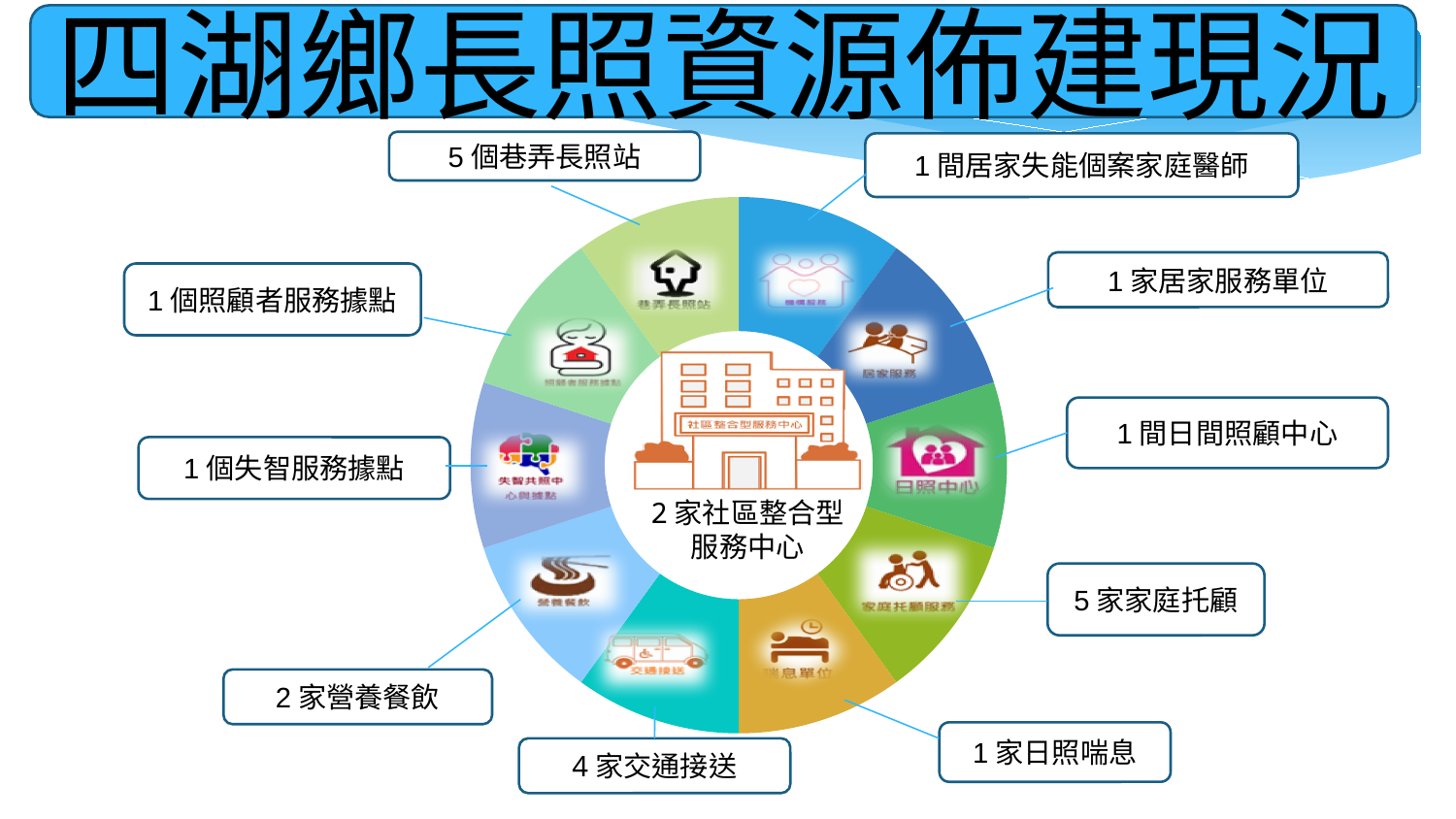
圖中家庭托顧有幾家？ 5 家 圖中日間照顧中心有幾間？ 1 間 圖中失智服務據點有幾個？ 1 個 這張圖的標題是什麼？ 四湖鄉長照資源佈建現況 環狀圖共分成幾個區塊？ 10 交通接送與營養餐飲，哪一項的數量較多？ 交通接送 圖中巷弄長照站有幾個？ 5 個 這是什麼類型的圖？ 環狀圖（甜甜圈圖） 圖中央標示的社區整合型服務中心有幾家？ 2 家 家庭托顧的數量比日照喘息多幾家？ 4 圖中交通接送有幾家？ 4 家 圖中營養餐飲有幾家？ 2 家